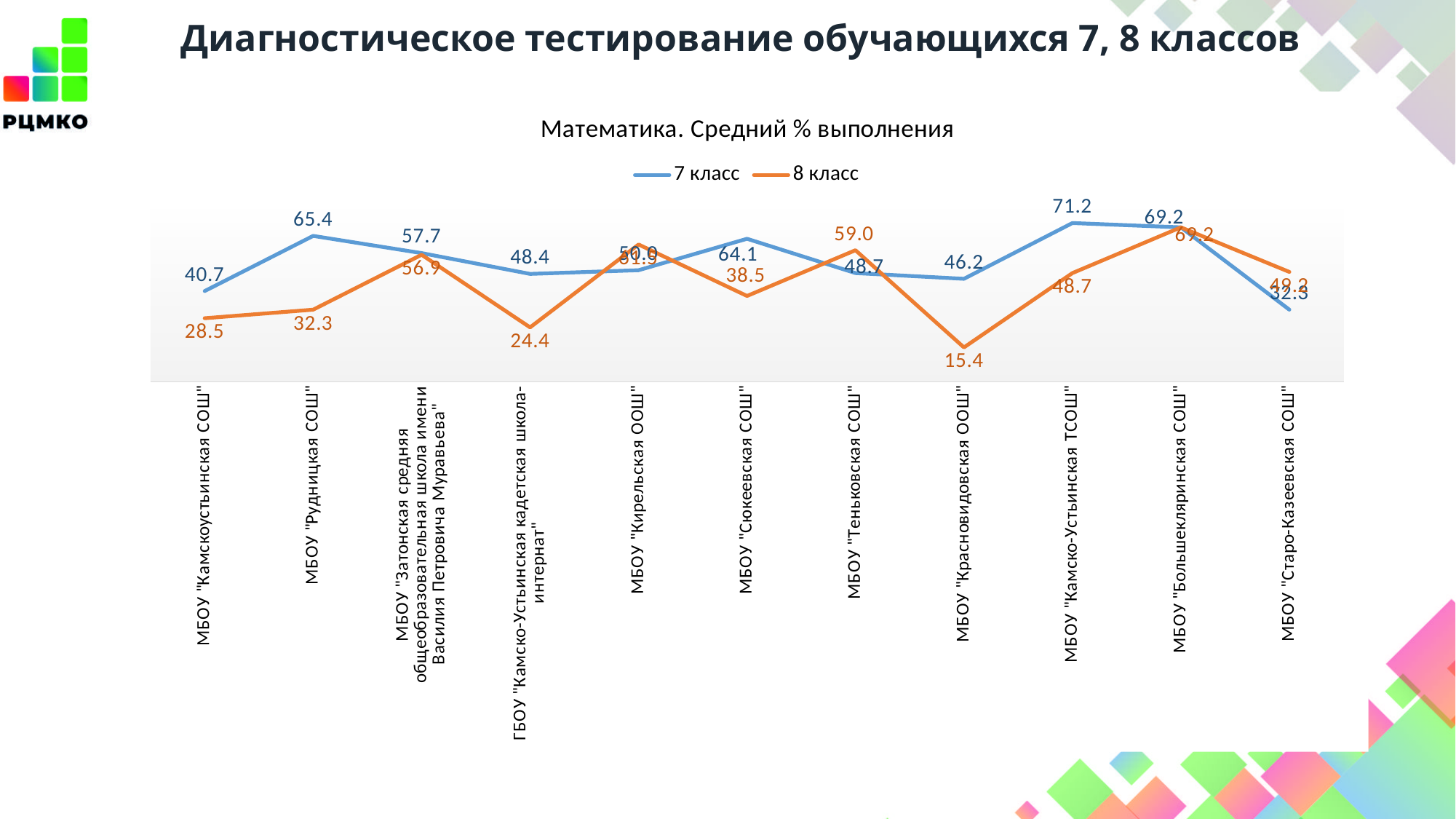
How many series does the legend list? 2 What is the value for 8 класс at ГБОУ "Камско-Устьинская кадетская школа-интернат"? 24.4 What is the value for 7 класс at МБОУ "Рудницкая СОШ"? 65.4 What kind of chart is shown on the slide? line chart How many schools (categories) are plotted along the x axis? 11 What is the value for 8 класс at МБОУ "Сюкеевская СОШ"? 38.5 What is the value for 8 класс at МБОУ "Красновидовская ООШ"? 15.4 What is the title of the chart? Математика. Средний % выполнения Which school has the lowest value for 8 класс? МБОУ "Красновидовская ООШ" Which school has the highest value for 7 класс? МБОУ "Камско-Устьинская ТСОШ" At МБОУ "Теньковская СОШ", which series has the larger value, 7 класс or 8 класс? 8 класс What is the difference between the 7 класс and 8 класс values at МБОУ "Рудницкая СОШ"? 33.1